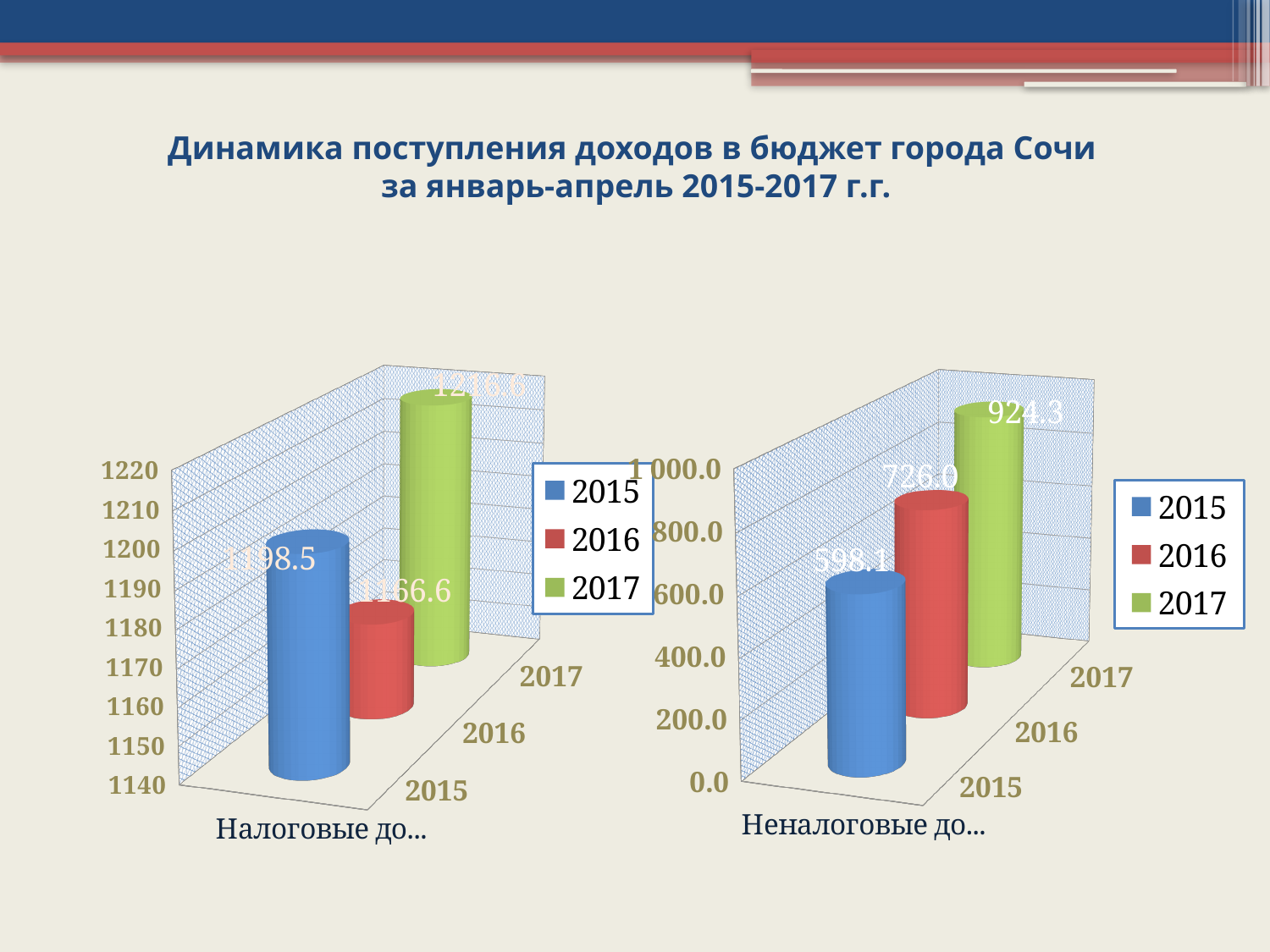
What kind of chart is the left chart (Налоговые до...)? bar chart In the right chart (Неналоговые до...), what is the value for 2017? 924.3 In the right chart (Неналоговые до...), do the values rise or fall from 2015 to 2017? rise In the right chart (Неналоговые до...), what is the difference between the 2016 and 2015 values? 127.9 In the left chart (Налоговые до...), which year has the lowest value? 2016 In the right chart (Неналоговые до...), what is the value for 2015? 598.1 In the left chart (Налоговые до...), what is the value for 2015? 1198.5 In the right chart (Неналоговые до...), is the value for 2016 greater or less than 800.0? less In the left chart (Налоговые до...), what is the value for 2016? 1166.6 How many series does the legend of the right chart (Неналоговые до...) list? 3 In the left chart (Налоговые до...), which is larger, the value for 2015 or the value for 2016? 2015 In the right chart (Неналоговые до...), which year has the highest value? 2017